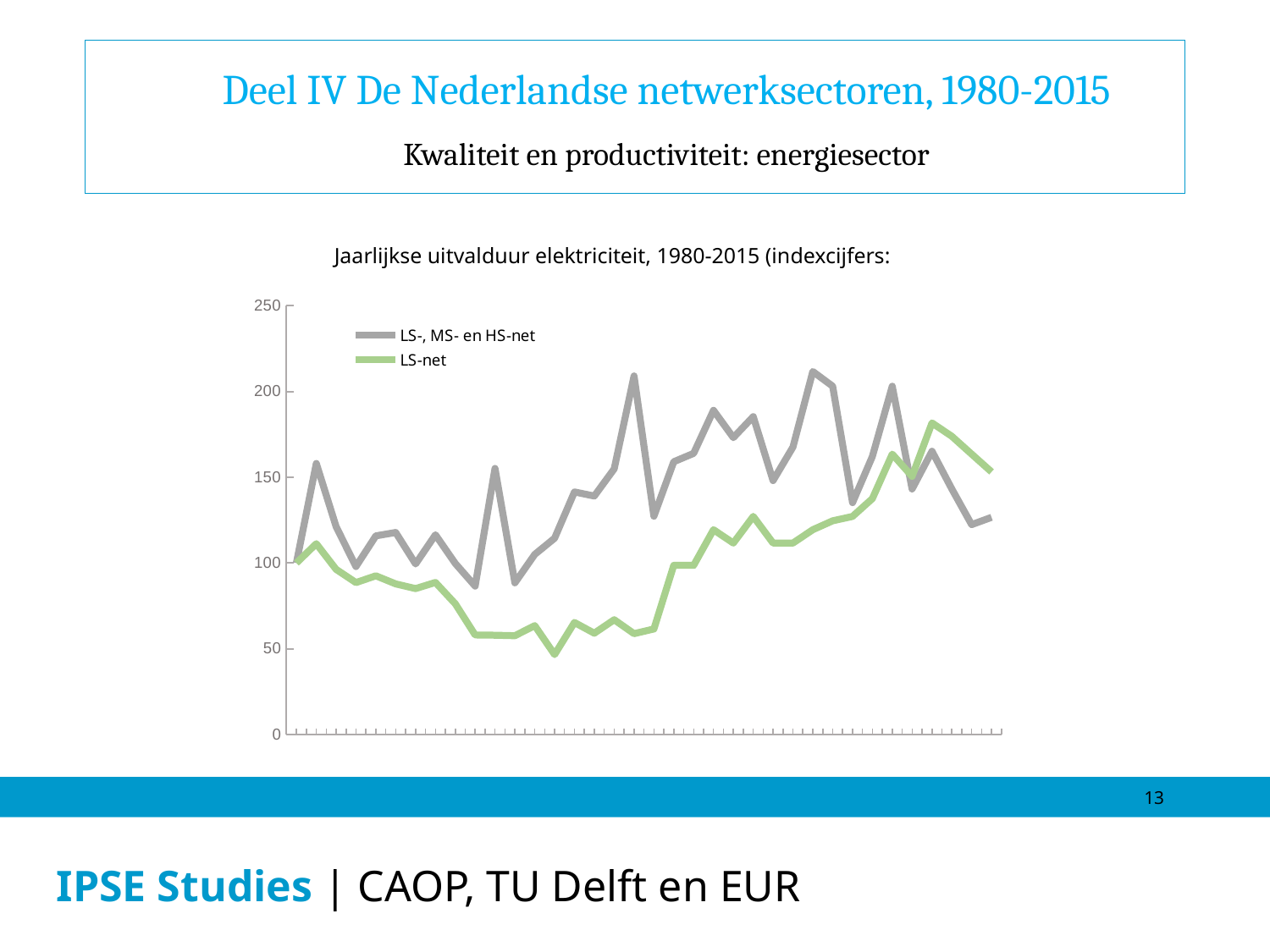
Does the LS-net line generally rise or fall over the second half of the period? rise What kind of chart is shown on the slide? line chart Which series reaches the higher peak value, LS-, MS- en HS-net or LS-net? LS-, MS- en HS-net How many series does the legend list? 2 Is the highest point of the LS-net line greater or less than 150? greater Is the final value of the LS-, MS- en HS-net line greater or less than 150? less Is the highest point of the LS-, MS- en HS-net line greater or less than 200? greater Which series has the lower values in the middle of the period? LS-net What are the two series named in the legend? LS-, MS- en HS-net and LS-net What is the highest value shown on the vertical axis? 250 What colour is the LS-net line? green